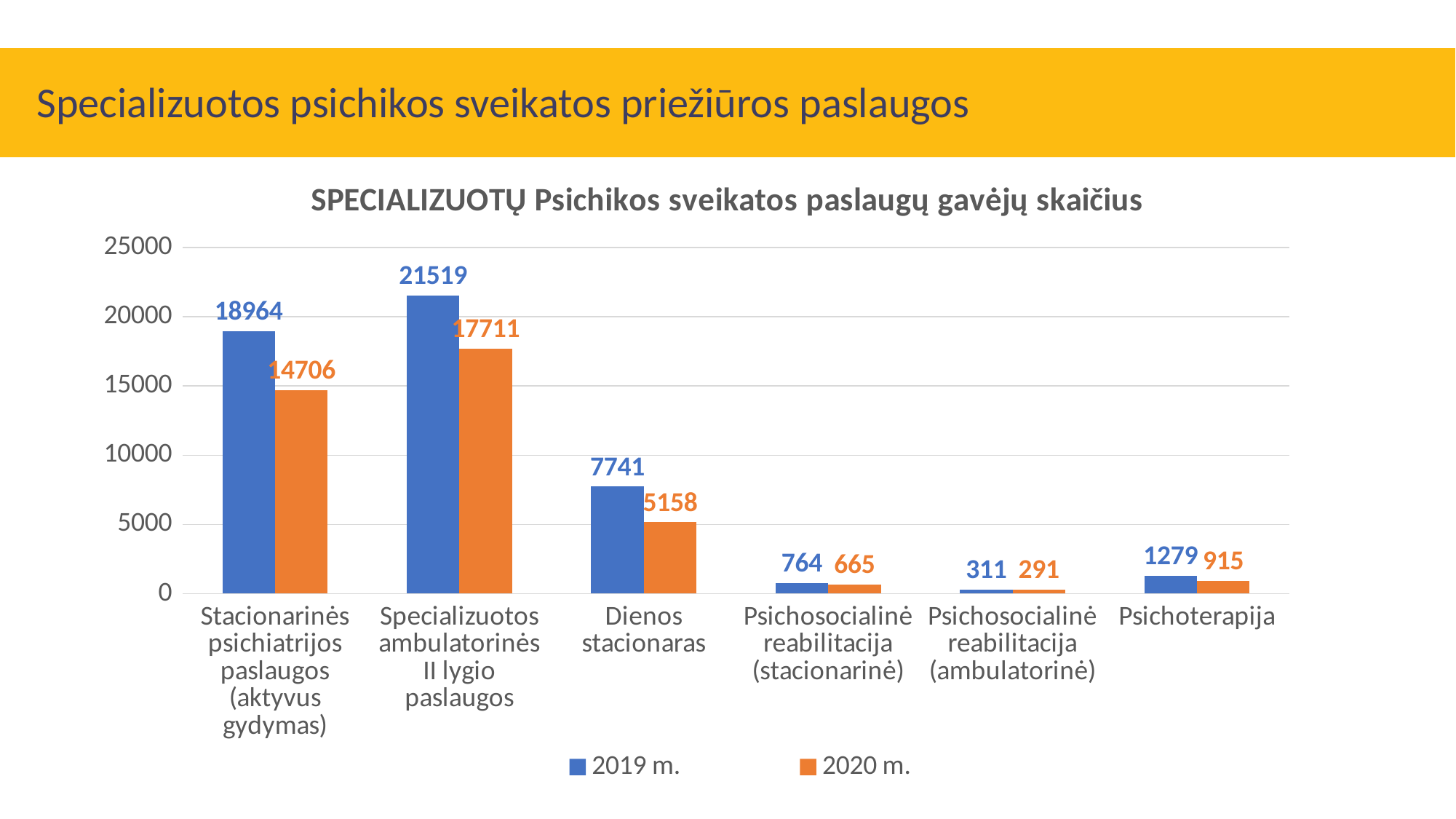
What is the 2020 m. value for Psichoterapija? 915 What kind of chart is shown on the slide? Bar chart Which category has the lowest 2020 m. value? Psichosocialinė reabilitacija (ambulatorinė) What is the difference between the 2019 m. and 2020 m. values for Dienos stacionaras? 2583 Which is larger for Psichosocialinė reabilitacija (stacionarinė): the 2019 m. value or the 2020 m. value? 2019 m. How many categories are shown on the x axis? 6 What is the difference between the 2019 m. and 2020 m. values for Specializuotos ambulatorinės II lygio paslaugos? 3808 What is the title of the chart? SPECIALIZUOTŲ Psichikos sveikatos paslaugų gavėjų skaičius Which category has the highest 2019 m. value? Specializuotos ambulatorinės II lygio paslaugos How many series does the legend list? 2 What is the 2019 m. value for Dienos stacionaras? 7741 What is the 2020 m. value for Stacionarinės psichiatrijos paslaugos (aktyvus gydymas)? 14706